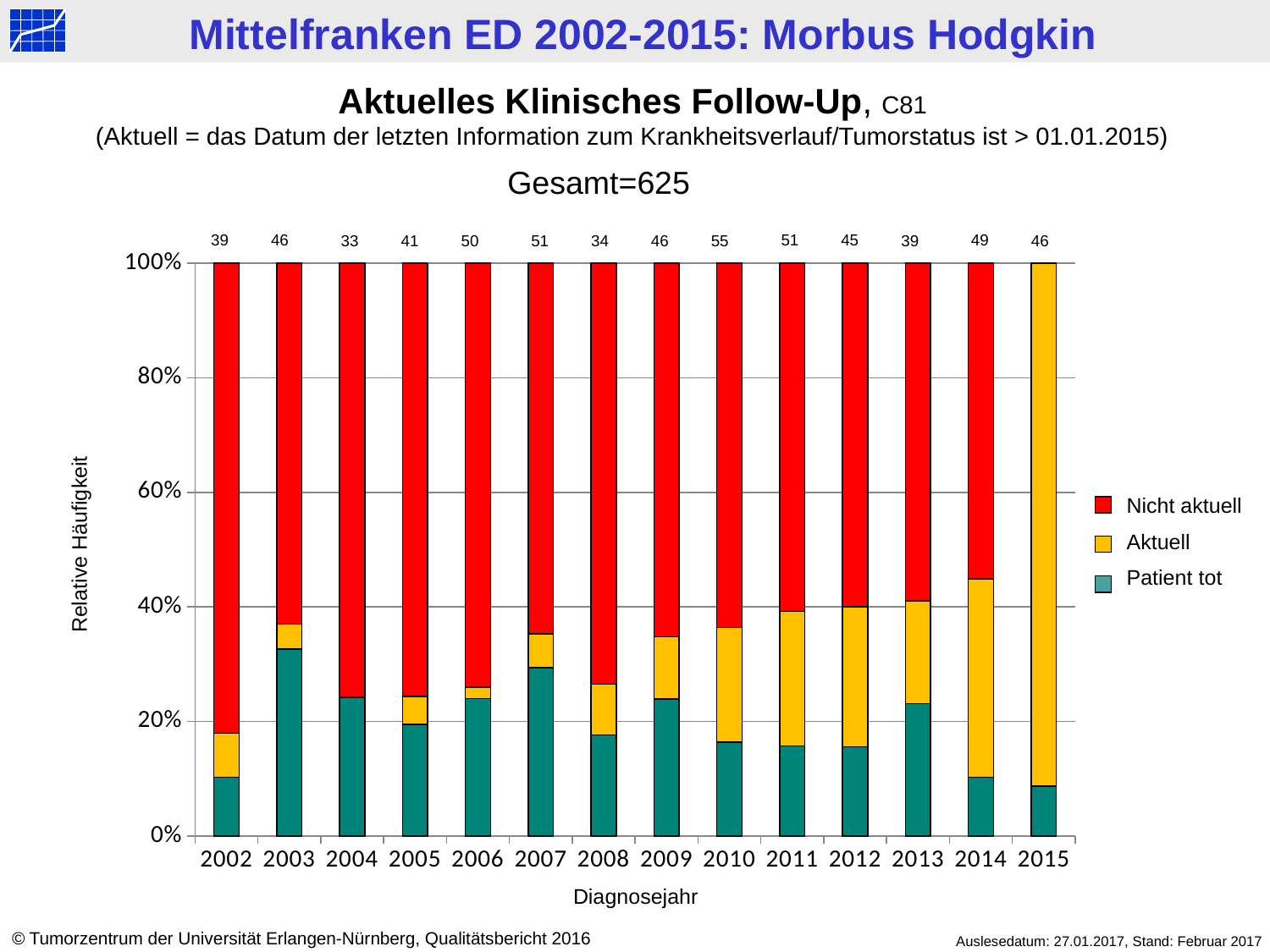
What kind of chart is shown on the slide? bar chart What number is printed above the bar for 2004? 33 How many diagnosis years (categories) are shown on the x axis? 14 Is the 'Patient tot' share for 2003 greater or less than 20%? greater Which diagnosis year has the highest number printed above its bar? 2010 Which diagnosis year has the lowest number printed above its bar? 2004 What is the difference between the numbers printed above the bars for 2010 and 2004? 22 How many series does the legend list? 3 Does the 'Aktuell' share generally rise or fall from 2002 to 2015? rise What number is printed above the bar for 2010? 55 Which year has the larger number printed above its bar, 2013 or 2014? 2014 Is the 'Aktuell' share for 2015 greater or less than 80%? greater